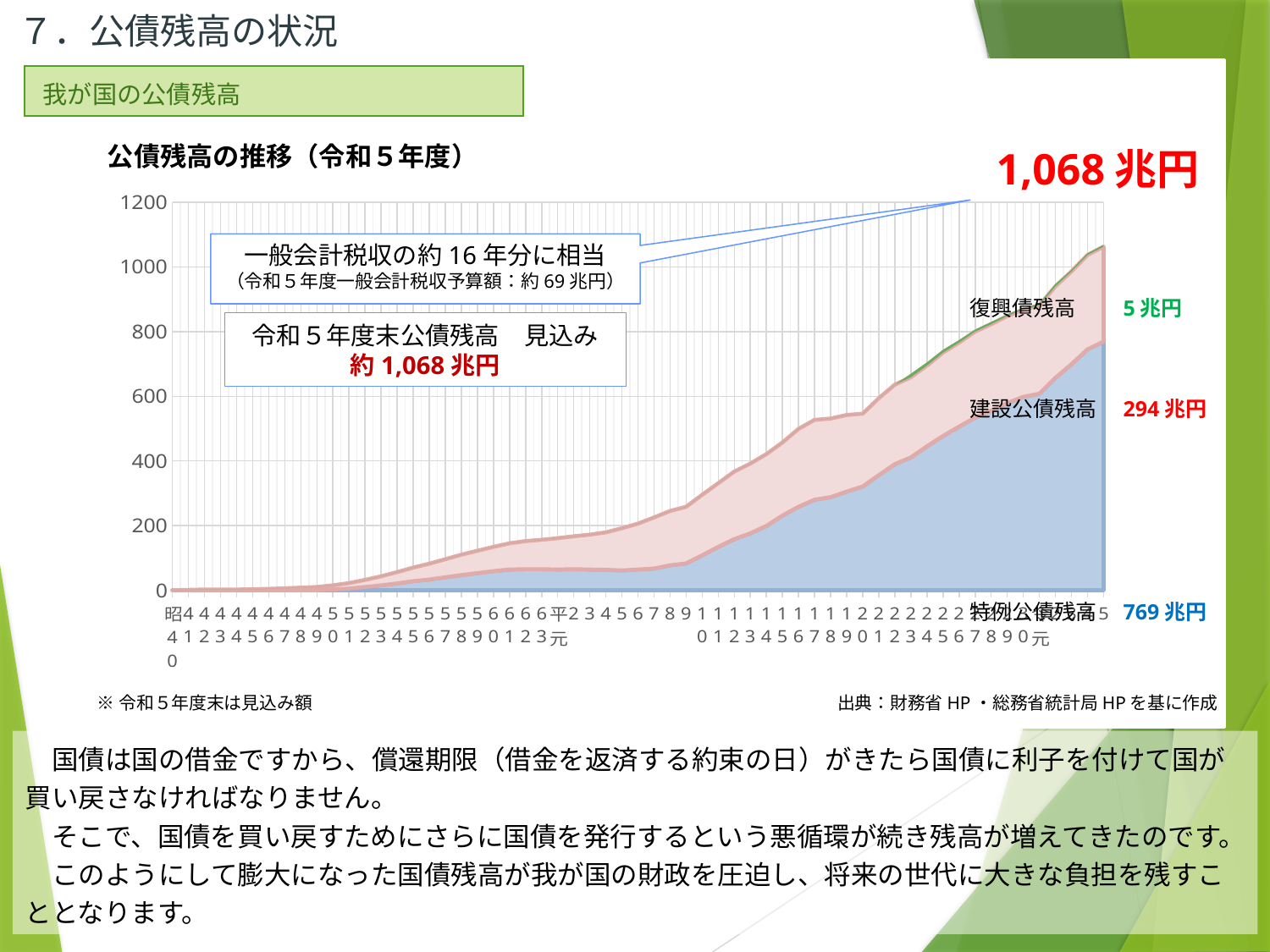
What is the total public debt outstanding shown for 令和５年度末? 1,068 兆円 What is the value labelled for 特例公債残高 at the end of the chart (令和５年度)? 769 兆円 Which of the three debt categories has the smallest value in 令和５年度? 復興債残高 What is the difference between 特例公債残高 (769 兆円) and 建設公債残高 (294 兆円) in 令和５年度? 475 兆円 Does the total public debt outstanding rise or fall over the period shown on the x axis? rise What is the value labelled for 復興債残高 at the end of the chart (令和５年度)? 5 兆円 What is the title of the chart? 公債残高の推移（令和５年度） Which of the three debt categories has the largest value in 令和５年度? 特例公債残高 Is the total public debt outstanding at the end of the chart greater or less than 1000 on the vertical axis? greater What kind of chart is used to show the public debt outstanding over time? Area chart (stacked) What is the value labelled for 建設公債残高 at the end of the chart (令和５年度)? 294 兆円 Which is larger in 令和５年度, 建設公債残高 or 復興債残高? 建設公債残高